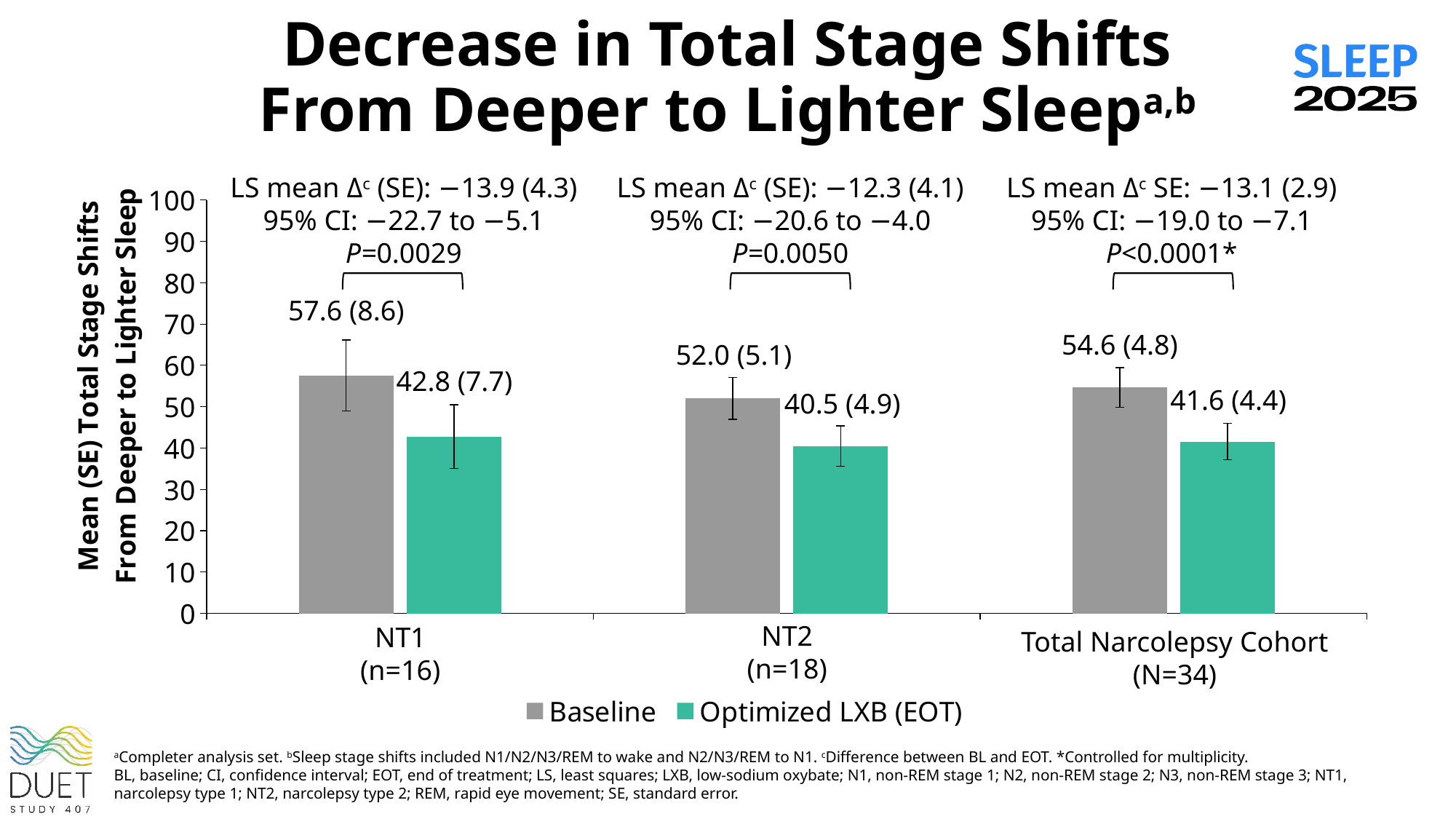
How many categories are shown on the x axis? 3 What is the Optimized LXB (EOT) value for NT2? 40.5 (4.9) What kind of chart is shown on the slide? Bar chart What is the difference between the Baseline mean and the Optimized LXB (EOT) mean for NT2? 11.5 What is the Baseline value for NT1? 57.6 (8.6) What is the Optimized LXB (EOT) value for the Total Narcolepsy Cohort? 41.6 (4.4) How many series does the legend list? 2 Which is larger for NT1: the Baseline mean or the Optimized LXB (EOT) mean? Baseline Is the Baseline value for NT2 greater or less than 50? greater Which category has the highest Baseline mean value? NT1 Which category has the lowest Optimized LXB (EOT) mean value? NT2 What is the Baseline value for the Total Narcolepsy Cohort? 54.6 (4.8)